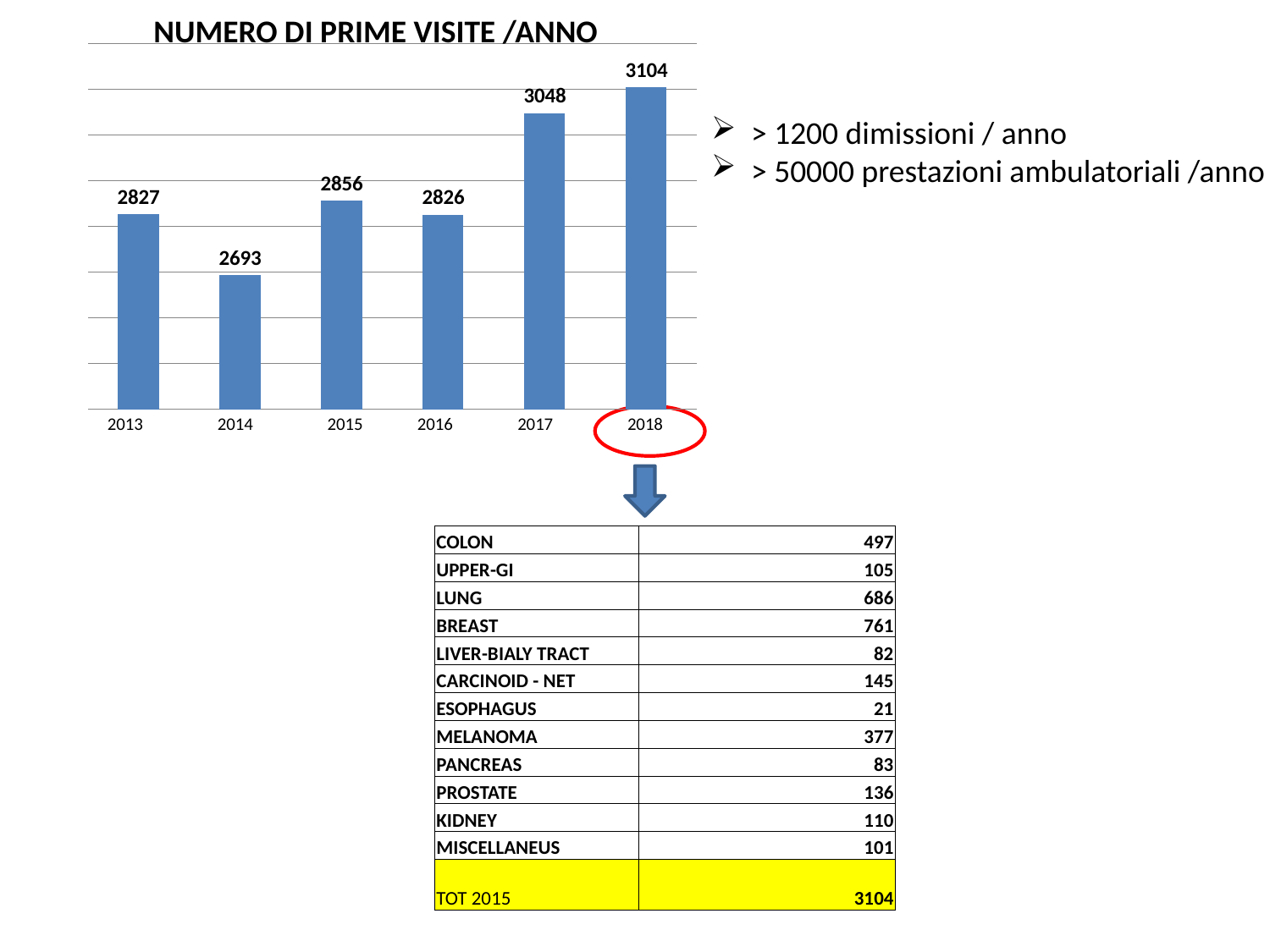
How many years are shown on the x axis of the chart? 6 What is the title of the chart? NUMERO DI PRIME VISITE /ANNO Which year has a larger value, 2013 or 2015? 2015 Which year has the lowest number of first visits? 2014 What is the difference between the values for 2018 and 2017? 56 What is the number of first visits in 2018? 3104 Which year has a larger value, 2017 or 2016? 2017 Which year has the highest number of first visits? 2018 What is the value shown for 2016? 2826 What kind of chart is shown on the slide? Bar chart What is the number of first visits in 2014? 2693 What is the difference between the values for 2015 and 2014? 163